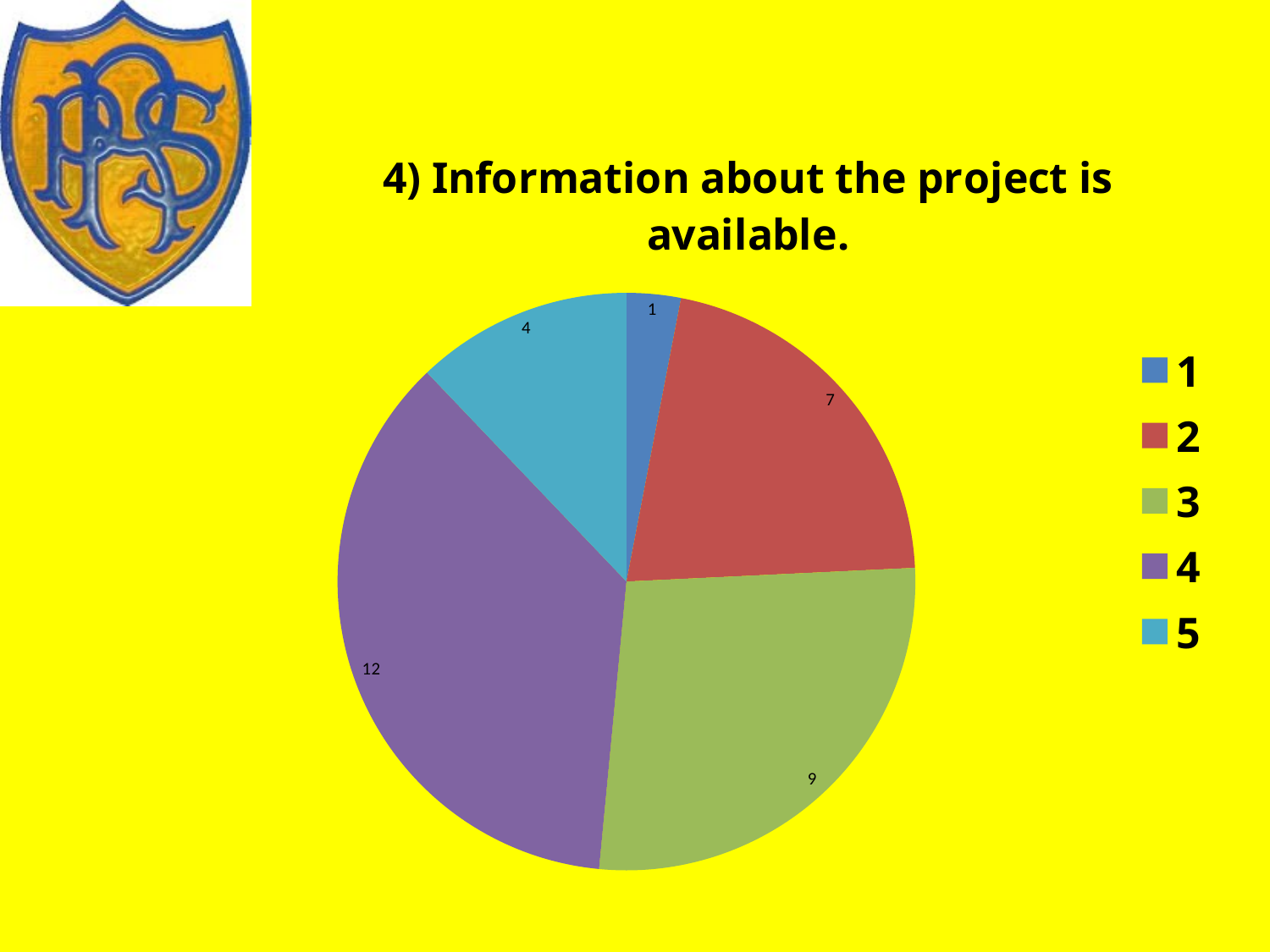
Which category has the largest slice? 4 What is the value for category 2? 7 What is the value for category 5? 4 Which is larger, the value for category 2 or the value for category 5? category 2 What is the difference between the values for category 4 and category 3? 3 What type of chart is shown on the slide? pie chart What is the value for category 4? 12 What is the total of all the slices in the pie? 33 Which category has the smallest slice? 1 What is the title of the chart? 4) Information about the project is available. How many categories does the legend list? 5 What is the value for category 1? 1